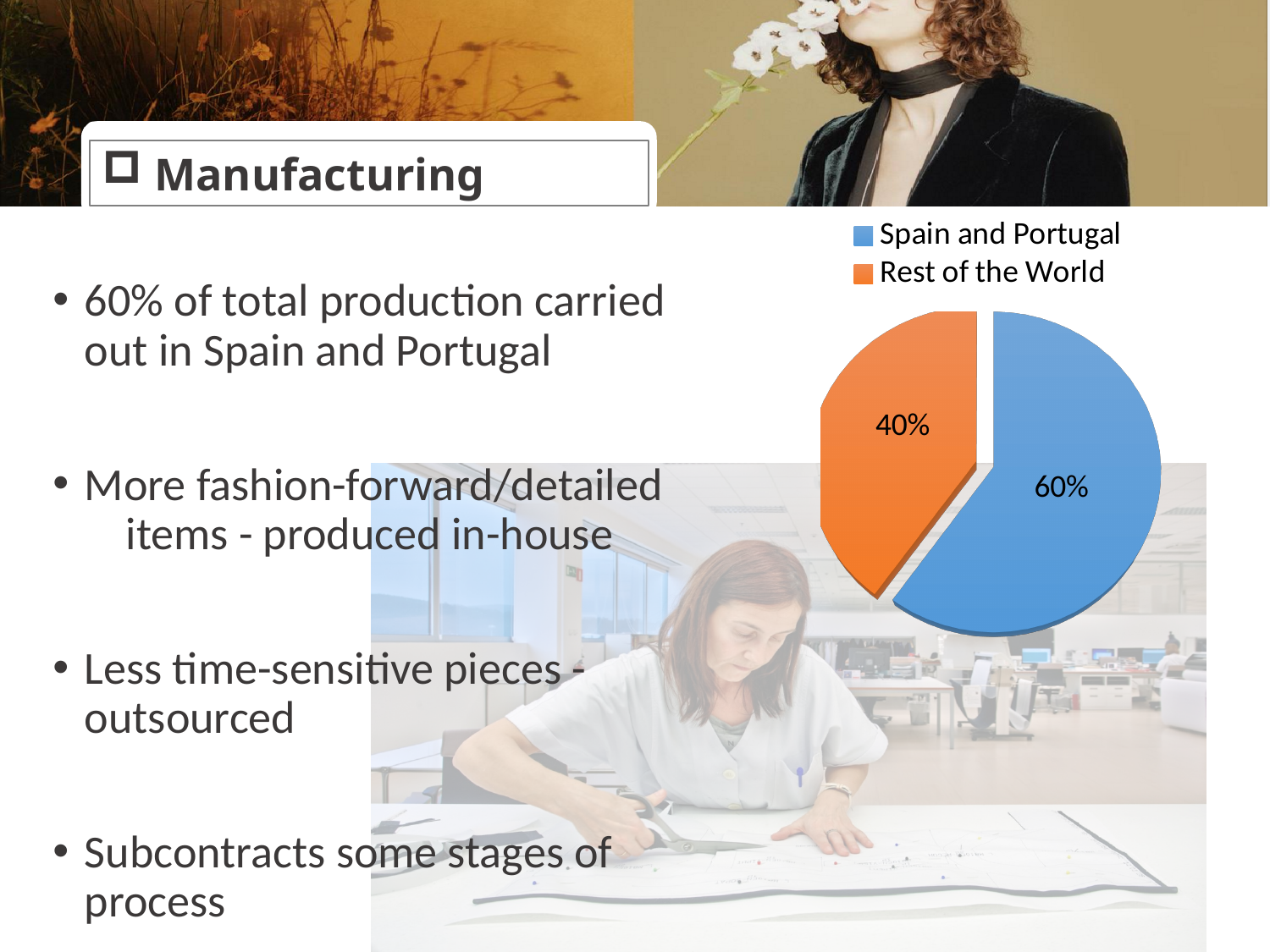
What is the difference in percentage points between the Spain and Portugal slice and the Rest of the World slice? 20% What colour is the Rest of the World slice? orange What colour is the Spain and Portugal slice? blue How many slices does the pie chart have? 2 What share of the pie does Rest of the World account for? 40% What kind of chart is shown on the slide? pie chart Which is larger, the Spain and Portugal slice or the Rest of the World slice? Spain and Portugal What share of the pie does Spain and Portugal account for? 60% Is the share for Rest of the World greater or less than 50%? less Which slice of the pie is the largest? Spain and Portugal How many entries does the legend list? 2 Which slice of the pie is the smallest? Rest of the World